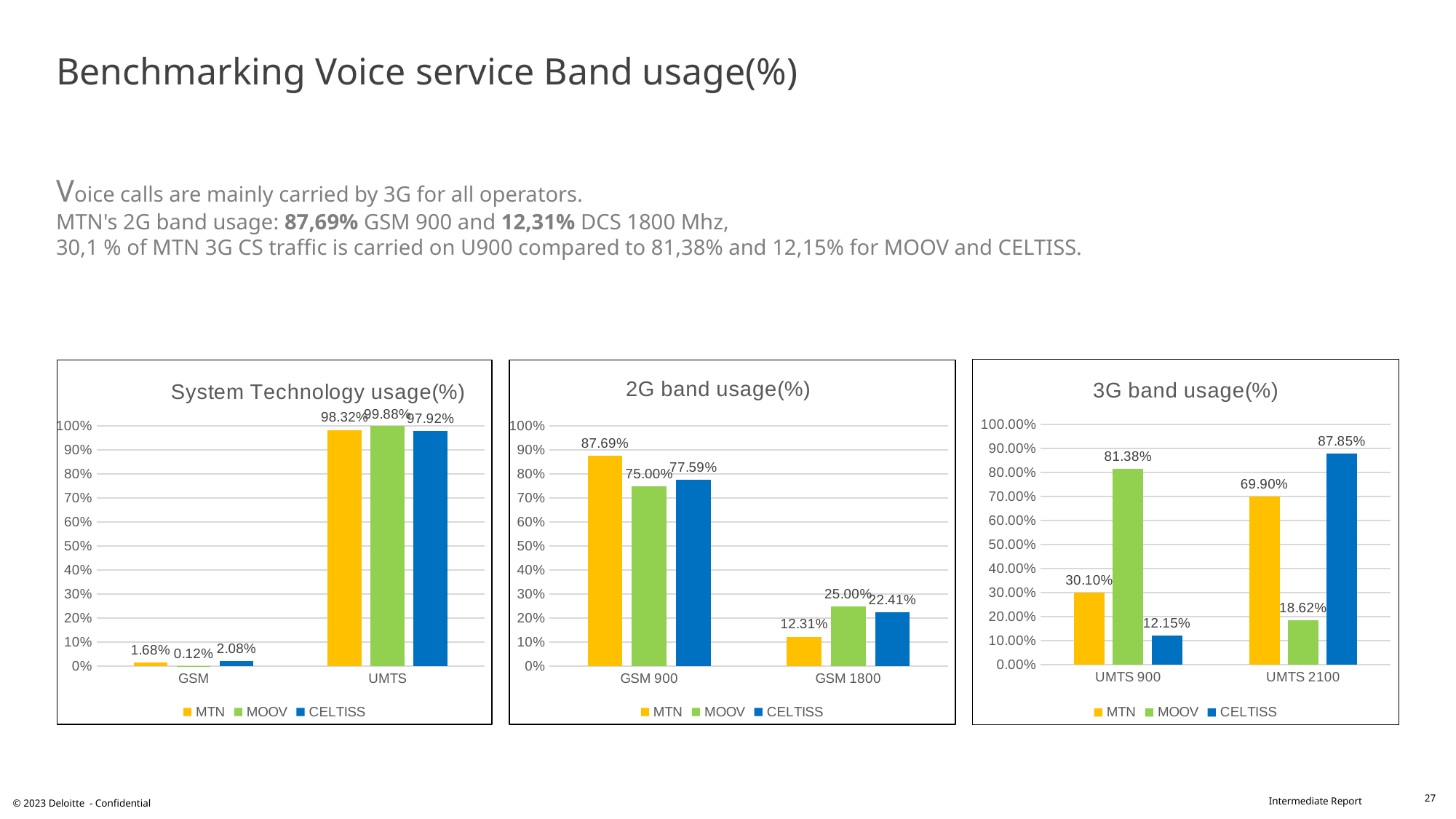
In the '2G band usage(%)' chart, what is the difference between MTN's GSM 900 value and MTN's GSM 1800 value? 75.38% How many series does the legend of the '3G band usage(%)' chart list? 3 In the '3G band usage(%)' chart, which is larger: MTN's UMTS 900 value or MOOV's UMTS 2100 value? MTN's UMTS 900 value In the 'System Technology usage(%)' chart, what is the value for MOOV in the UMTS category? 99.88% In the 'System Technology usage(%)' chart, what is the value for CELTISS in the GSM category? 2.08% In the '2G band usage(%)' chart, what is the value for MTN in the GSM 900 category? 87.69% In the '3G band usage(%)' chart, which operator has the highest value in the UMTS 900 category? MOOV In the '2G band usage(%)' chart, is the value for CELTISS in GSM 900 greater or less than 70%? greater In the '3G band usage(%)' chart, what is the value for CELTISS in the UMTS 2100 category? 87.85% What type of chart is the '2G band usage(%)' chart? Bar chart In the 'System Technology usage(%)' chart, which operator has the lowest value in the GSM category? MOOV In the '2G band usage(%)' chart, which operator has the highest value in the GSM 1800 category? MOOV